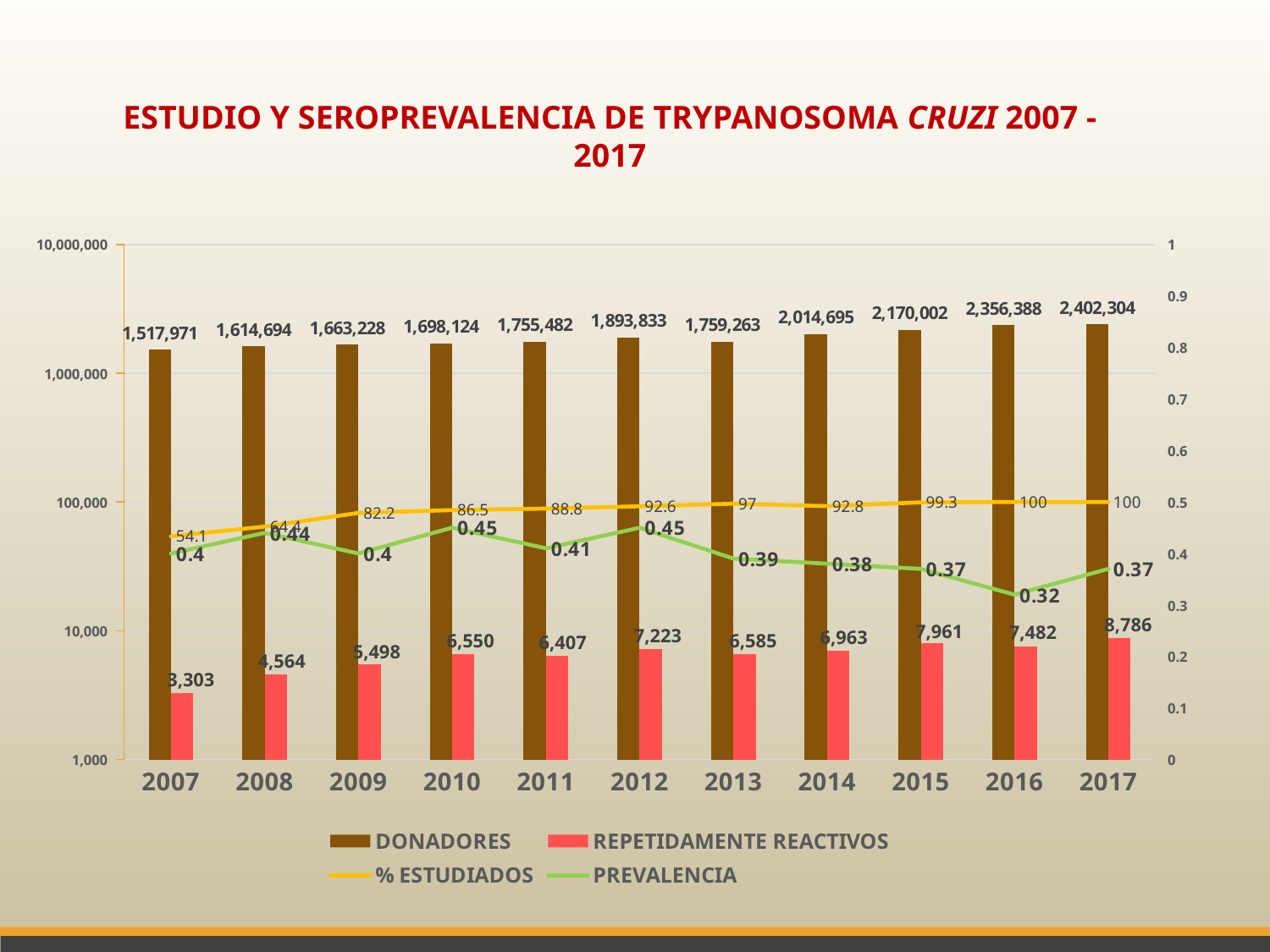
What is the REPETIDAMENTE REACTIVOS value for 2012? 7,223 In which year is the DONADORES value highest? 2017 In which year is the PREVALENCIA value lowest? 2016 Which year has the larger DONADORES value, 2012 or 2013? 2012 Does the % ESTUDIADOS line generally rise or fall from 2007 to 2017? rise What is the PREVALENCIA value for 2016? 0.32 What is the difference between the REPETIDAMENTE REACTIVOS values for 2017 and 2007? 5,483 What is the % ESTUDIADOS value for 2013? 97 What is the DONADORES value for 2017? 2,402,304 In which year is the REPETIDAMENTE REACTIVOS value lowest? 2007 How many series does the legend list? 4 How many years are shown on the x axis? 11